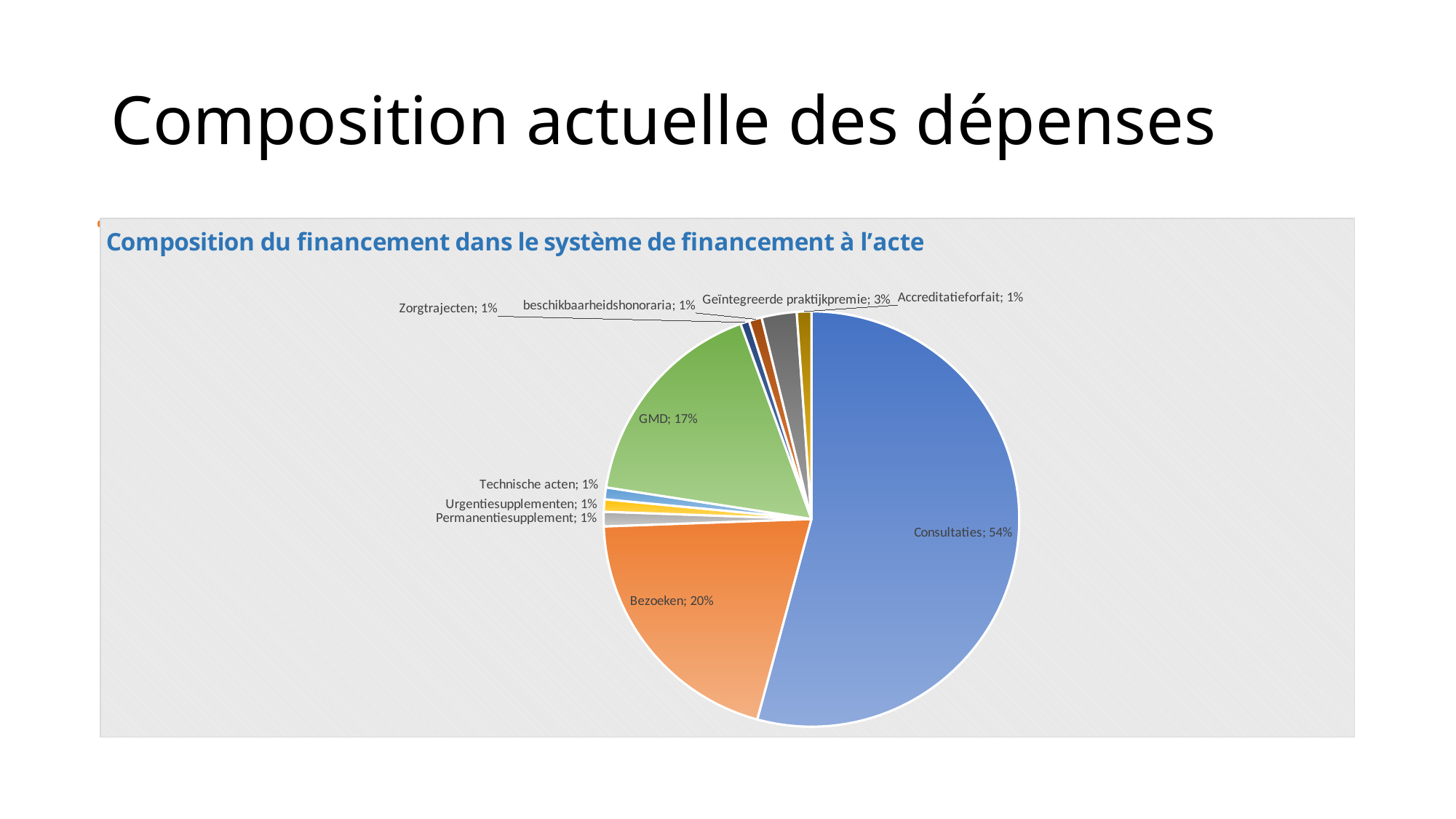
Which is larger, the share for GMD or the share for Geïntegreerde praktijkpremie? GMD What is the value shown for Geïntegreerde praktijkpremie? 3% What is the difference between the shares of Consultaties and Bezoeken? 34 percentage points What is the value shown for Zorgtrajecten? 1% How many slices does the pie chart have? 10 Which category has the largest slice of the pie? Consultaties What is the difference between the shares of Bezoeken and GMD? 3 percentage points What share of the pie does Consultaties represent? 54% What share of the pie does Bezoeken represent? 20% What kind of chart is shown on the slide? Pie chart What is the title of the chart? Composition du financement dans le système de financement à l'acte What is the value shown for GMD? 17%